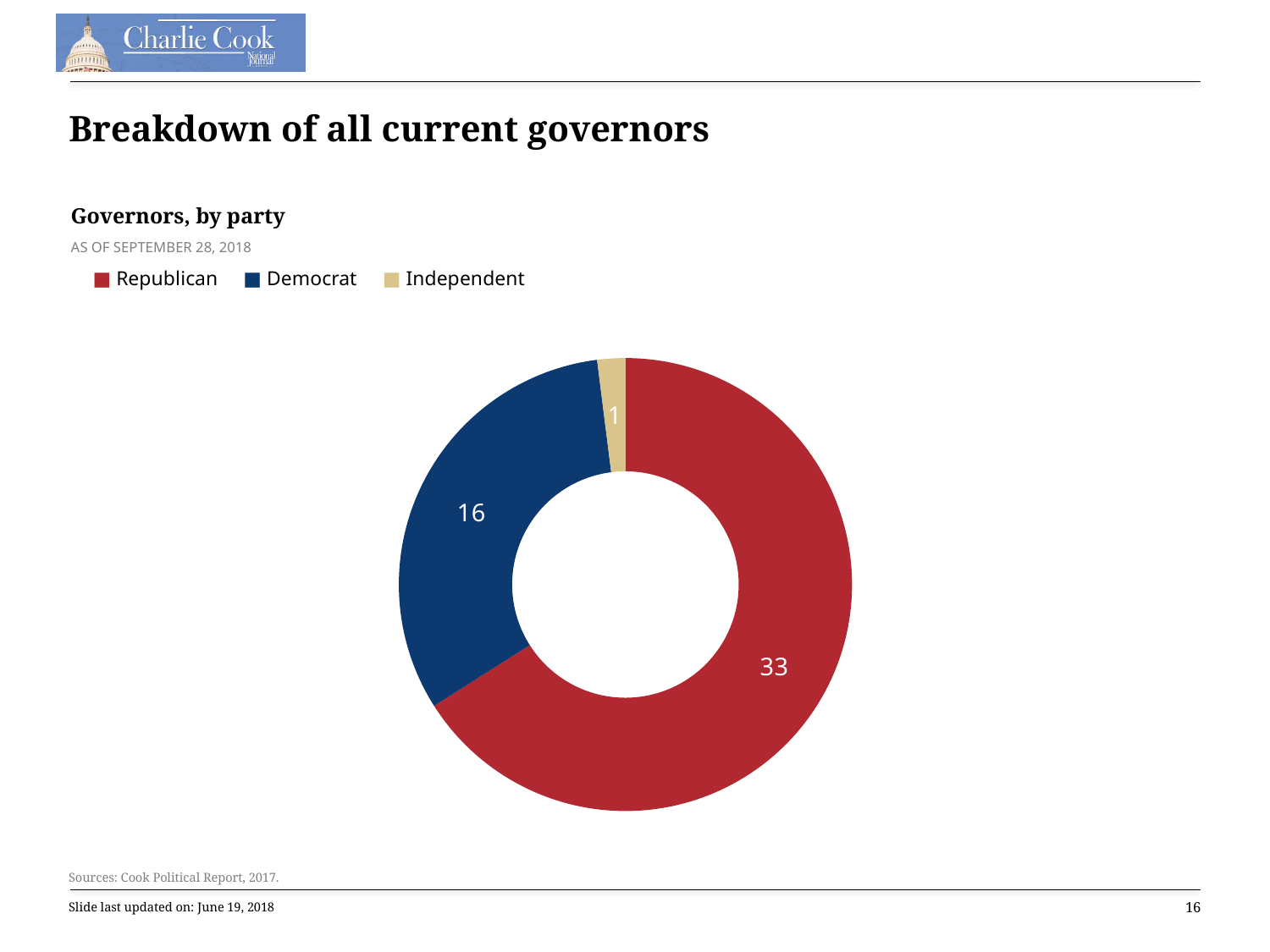
What colour represents Democrat in the chart? Blue What share of all governors are Republican? 66% Which party has the most governors? Republican How many parties are shown in the chart? 3 How many governors are Republican according to the chart? 33 What type of chart is used to show governors by party? Pie chart (donut) How many more Republican governors are there than Democrat governors? 17 Which party has more governors, Democrat or Independent? Democrat What is the total number of governors shown in the chart? 50 How many governors are Independent according to the chart? 1 How many governors are Democrat according to the chart? 16 Which party has the fewest governors? Independent